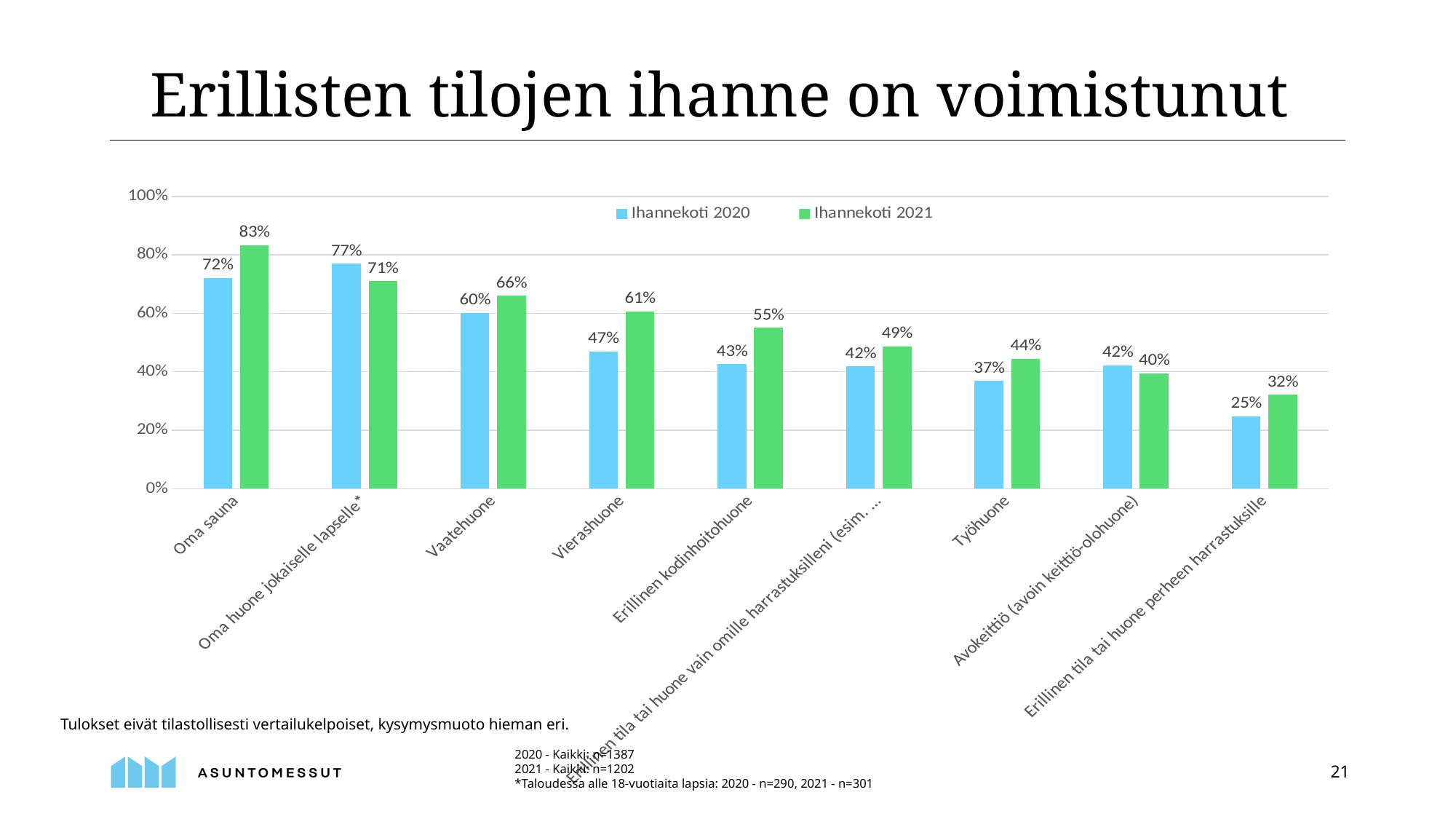
How many series does the legend list? 2 What colour are the Ihannekoti 2021 bars? Green What is the Ihannekoti 2021 value for Oma sauna? 83% What kind of chart is shown on the slide? Bar chart Which category has the lowest Ihannekoti 2020 value? Erillinen tila tai huone perheen harrastuksille Which is larger for Oma huone jokaiselle lapselle*: the Ihannekoti 2020 value or the Ihannekoti 2021 value? Ihannekoti 2020 How many categories are shown on the x axis? 9 What is the difference between the Ihannekoti 2021 and Ihannekoti 2020 values for Vierashuone? 14% What is the Ihannekoti 2020 value for Vierashuone? 47% Is the Ihannekoti 2021 value for Erillinen kodinhoitohuone greater or less than 40%? greater Which category has the highest Ihannekoti 2021 value? Oma sauna What is the Ihannekoti 2020 value for Työhuone? 37%